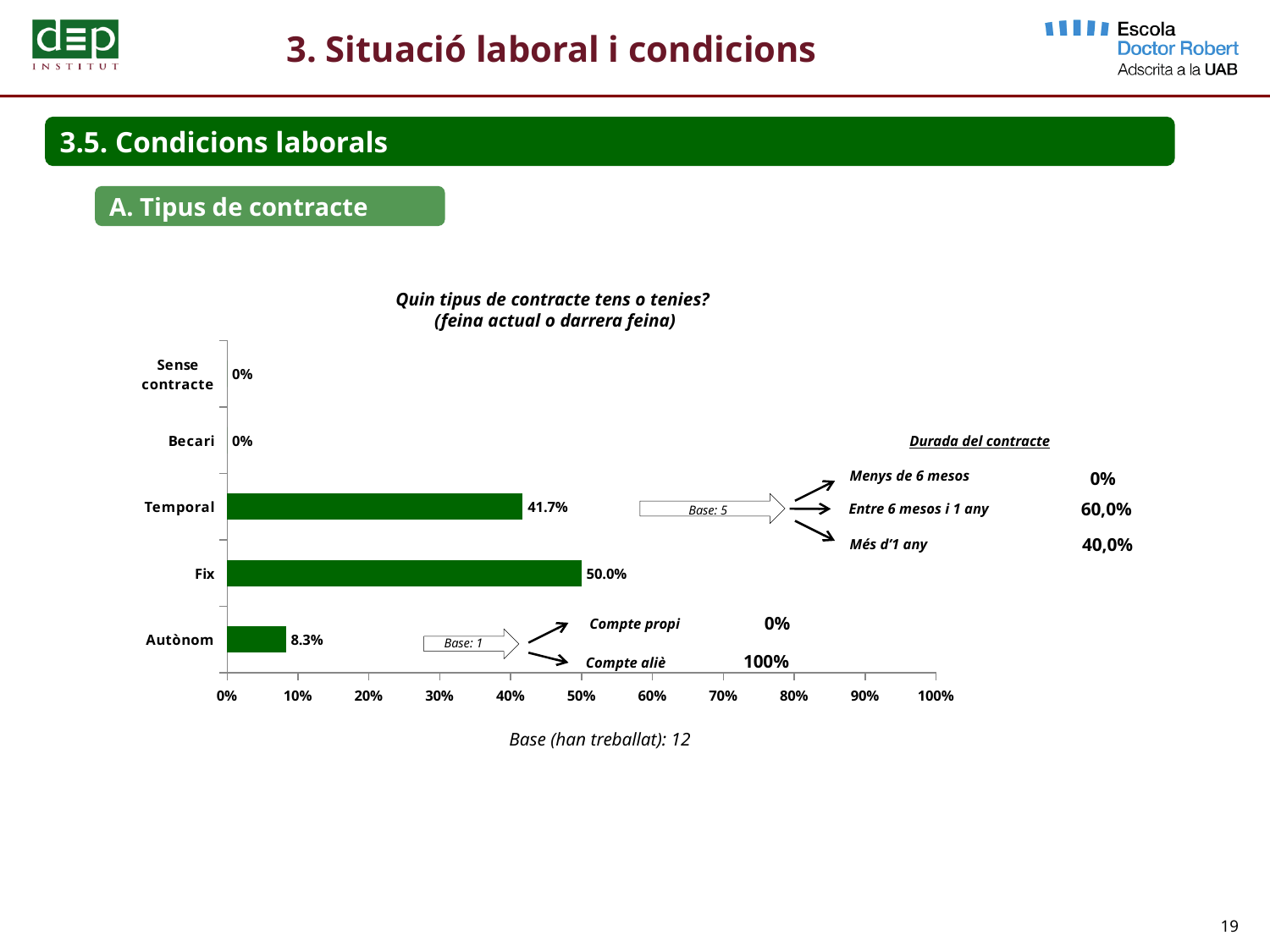
What kind of chart is shown on the slide? Bar chart Which is larger, the value for Temporal or the value for Autònom? Temporal What is the base (number of respondents) stated below the chart? 12 What is the value for Autònom? 8.3% What is the value for Becari? 0% What is the title of the chart? Quin tipus de contracte tens o tenies? (feina actual o darrera feina) How many categories are shown on the chart? 5 What is the value for Temporal? 41.7% What is the value for Fix? 50.0% Is the value for Temporal greater or less than 40%? greater What is the difference between the values for Fix and Temporal? 8.3% Which category has the highest value? Fix